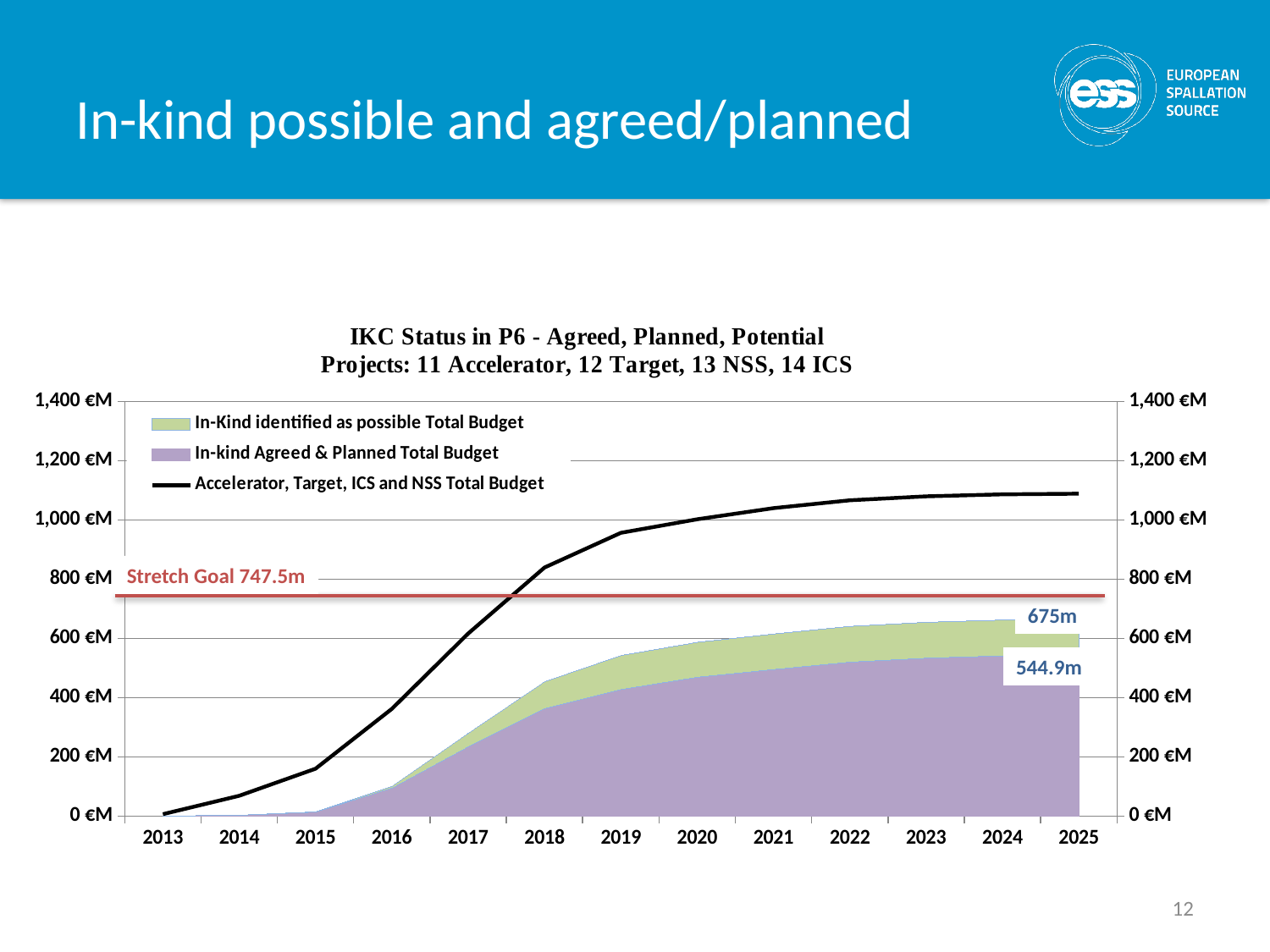
What is the value of the Stretch Goal marked by the red line on the chart? 747.5m In 2020, which is larger: the Accelerator, Target, ICS and NSS Total Budget line or the In-kind Agreed & Planned Total Budget area? Accelerator, Target, ICS and NSS Total Budget Is the Accelerator, Target, ICS and NSS Total Budget line in 2025 greater or less than 1,000 €M? greater How many years are shown along the x axis of the chart? 13 Does the Accelerator, Target, ICS and NSS Total Budget line rise or fall from 2013 to 2025? rises Is the Accelerator, Target, ICS and NSS Total Budget line in 2015 greater or less than 200 €M? less What value is labelled on the upper (green) area of the chart? 675m Is the In-kind Agreed & Planned Total Budget in 2017 greater or less than 400 €M? less What kind of chart is shown on the slide? combination area and line chart What colour represents the In-kind Agreed & Planned Total Budget in the chart legend? purple What value is labelled on the lower (purple) area of the chart? 544.9m How many series does the chart legend list? 3